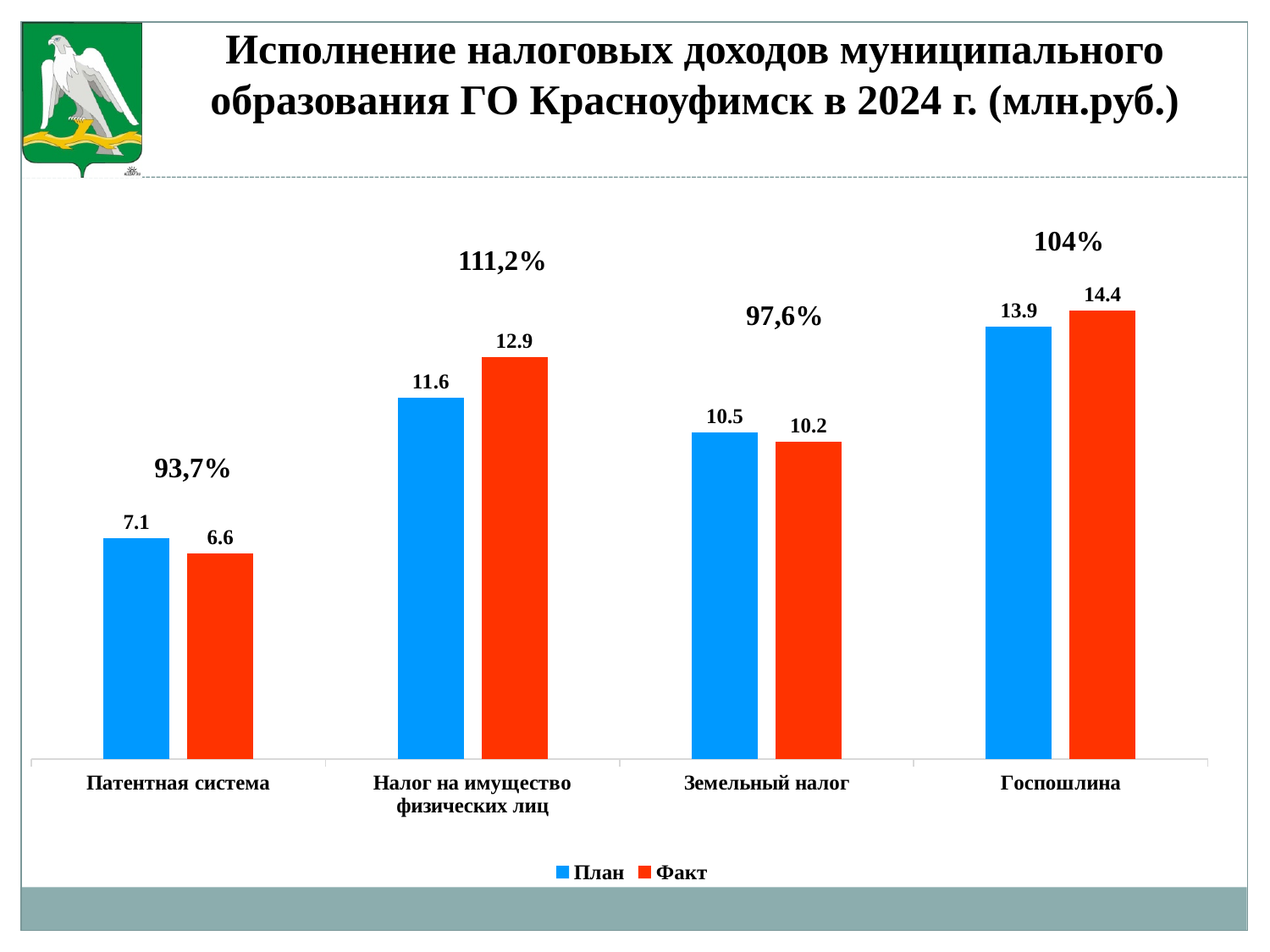
How many series does the legend list? 2 Which colour represents the Факт series in the legend? Red Which category has the lowest План value? Патентная система What percentage is shown above the bars for Земельный налог? 97,6% Which category has the highest Факт value? Госпошлина What kind of chart is shown on the slide? Bar chart What is the План value for Госпошлина? 13.9 What is the Факт value for Налог на имущество физических лиц? 12.9 Which is larger for Земельный налог, the План value or the Факт value? План What is the Факт value for Патентная система? 6.6 What is the difference between the Факт and План values for Налог на имущество физических лиц? 1.3 How many categories are shown on the x axis? 4